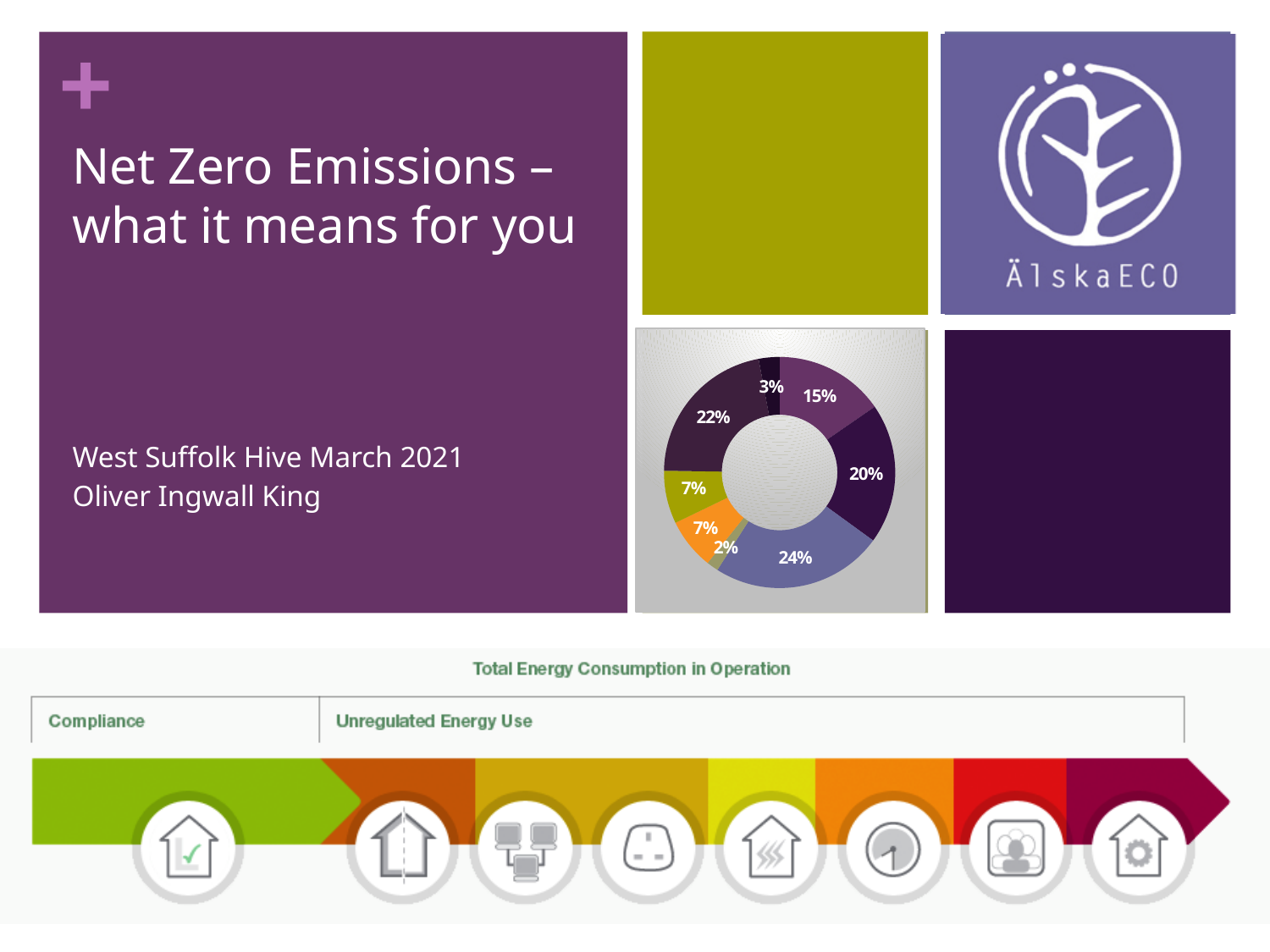
What percentage is shown on the green slice of the doughnut chart? 7% On the doughnut chart, which is larger: the 22% slice or the 20% slice? The 22% slice What is the difference between the largest slice (24%) and the smallest slice (2%) on the doughnut chart? 22% How many slices on the doughnut chart are labelled 7%? 2 How many slices does the doughnut chart have? 8 What is the smallest percentage shown on the doughnut chart? 2% Does the doughnut chart on the slide include a legend? No What do the percentages on the doughnut chart add up to? 100% What is the largest percentage shown on the doughnut chart? 24% What kind of chart is shown in the middle-right panel of the slide? Doughnut (pie) chart What is the difference between the 22% slice and the 15% slice on the doughnut chart? 7% What percentage is shown on the light purple (lavender) slice at the bottom of the doughnut chart? 24%